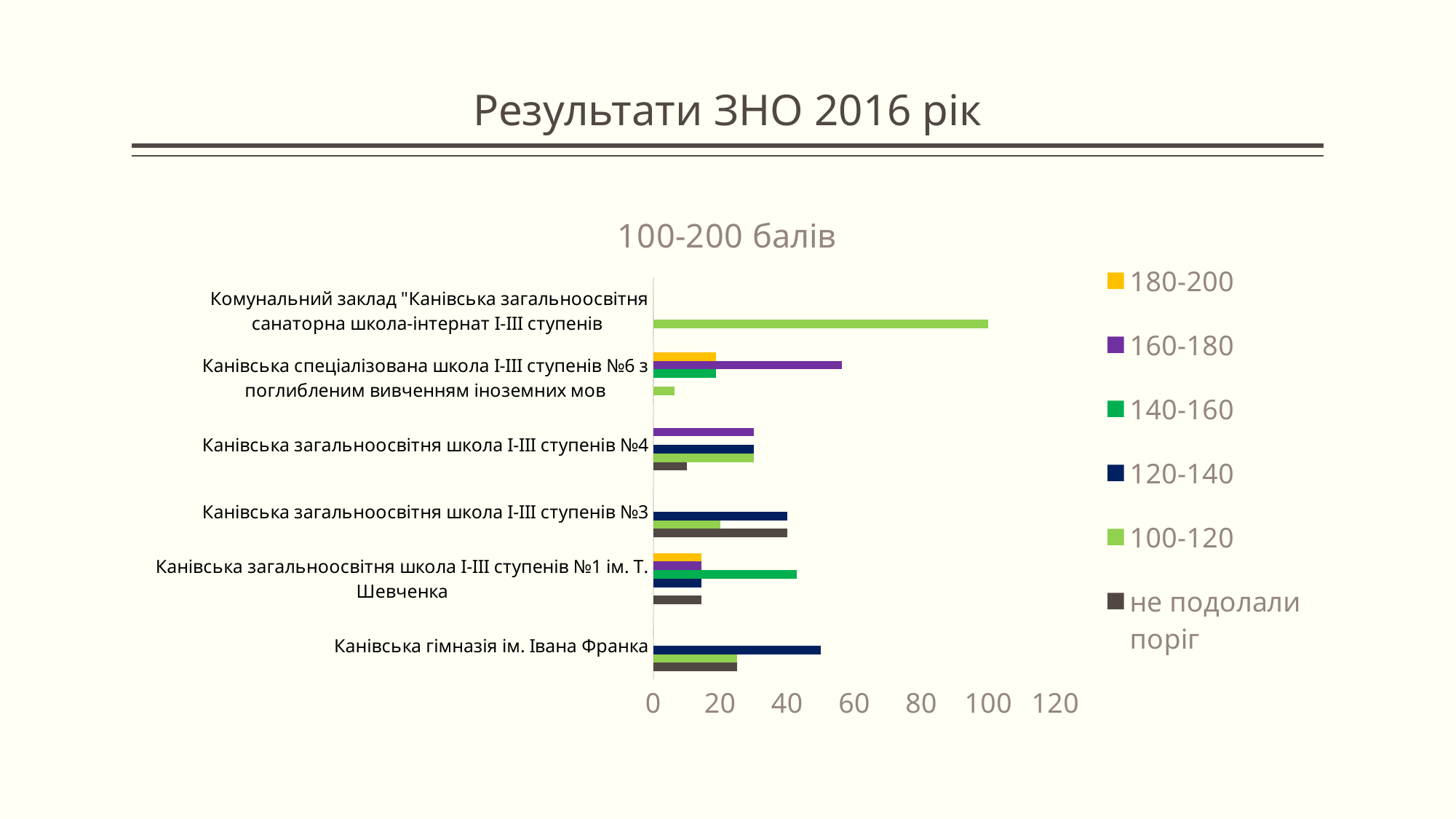
Is the 100-120 value for Комунальний заклад "Канівська загальноосвітня санаторна школа-інтернат І-ІІІ ступенів" greater or less than 80? greater Is the 160-180 value for Канівська спеціалізована школа І-ІІІ ступенів №6 greater or less than 40? greater What kind of chart is shown on the slide? bar chart Is the 100-120 value for Канівська спеціалізована школа І-ІІІ ступенів №6 greater or less than 20? less What is the title of the chart? 100-200 балів For Канівська загальноосвітня школа І-ІІІ ступенів №3, which is larger: the 120-140 value or the 100-120 value? 120-140 Which school has the highest 100-120 value? Комунальний заклад "Канівська загальноосвітня санаторна школа-інтернат І-ІІІ ступенів How many schools (categories) are plotted on the chart? 6 How many series does the legend list? 6 For Канівська загальноосвітня школа І-ІІІ ступенів №1 ім. Т. Шевченка, which is larger: the 140-160 value or the 120-140 value? 140-160